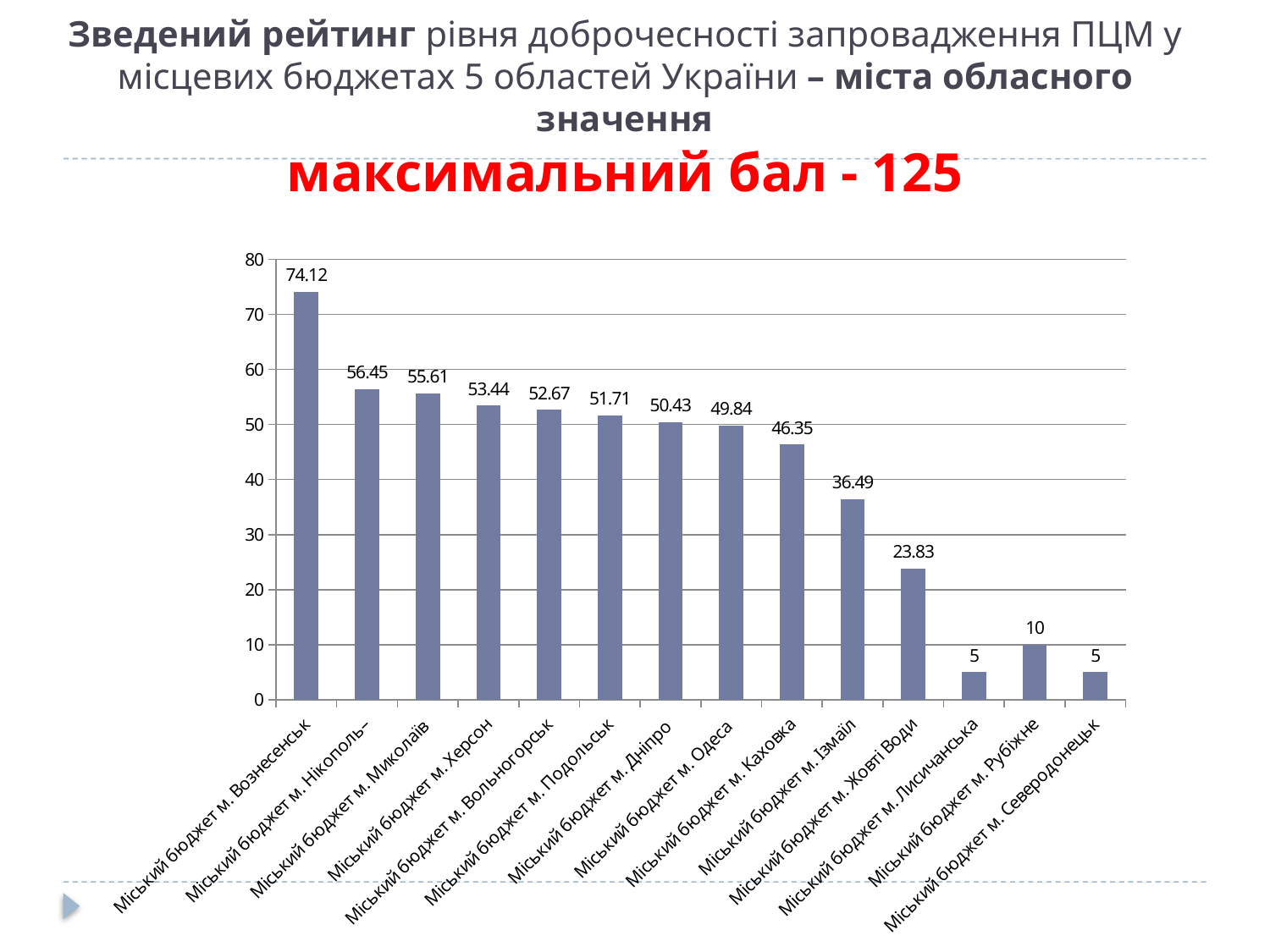
What is the difference between the values for Міський бюджет м. Вознесенськ and Міський бюджет м. Нікополь? 17.67 What is the value for Міський бюджет м. Жовті Води? 23.83 What type of chart is shown on the slide? bar chart Which is larger, the value for Міський бюджет м. Одеса or the value for Міський бюджет м. Каховка? Міський бюджет м. Одеса What is the value for Міський бюджет м. Вознесенськ? 74.12 What is the value for Міський бюджет м. Рубіжне? 10 How many city budgets (bars) are shown in the chart? 14 What maximum score is stated in red text above the chart? 125 What is the value for Міський бюджет м. Дніпро? 50.43 Do the values generally rise or fall from left to right across the chart? fall Which city budget has the highest value in the chart? Міський бюджет м. Вознесенськ Is the value for Міський бюджет м. Ізмаїл greater or less than 40? less